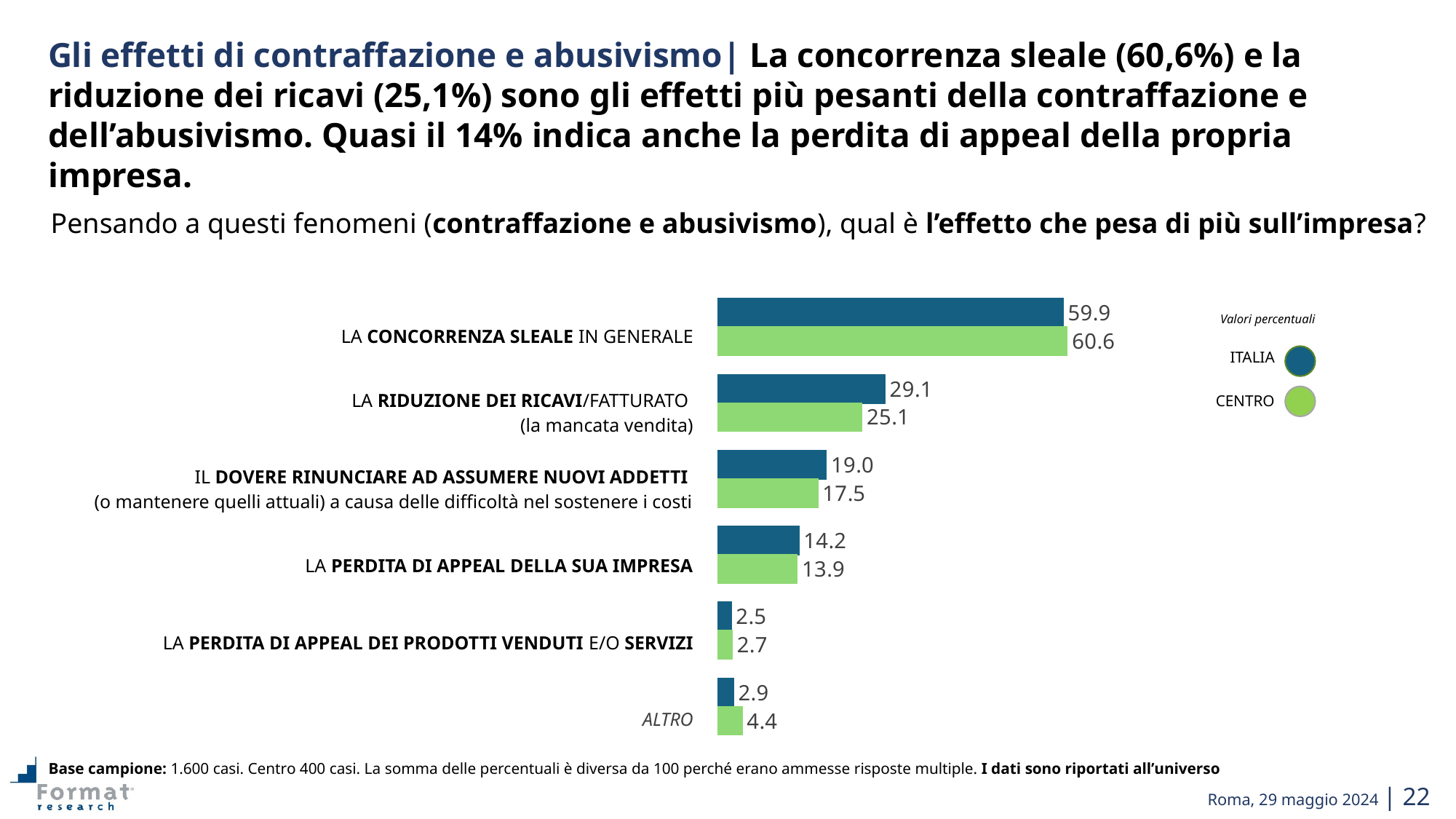
How many categories are shown in the chart? 6 Which category has the highest CENTRO value? LA CONCORRENZA SLEALE IN GENERALE What is the CENTRO value for LA RIDUZIONE DEI RICAVI/FATTURATO? 25.1 For IL DOVERE RINUNCIARE AD ASSUMERE NUOVI ADDETTI, which series has the larger value, ITALIA or CENTRO? ITALIA What is the difference between the ITALIA and CENTRO values for LA RIDUZIONE DEI RICAVI/FATTURATO? 4.0 How many series does the legend list? 2 What is the CENTRO value for ALTRO? 4.4 Which category has the lowest ITALIA value? LA PERDITA DI APPEAL DEI PRODOTTI VENDUTI E/O SERVIZI What kind of chart is shown on the slide? Bar chart What is the ITALIA value for LA PERDITA DI APPEAL DELLA SUA IMPRESA? 14.2 Which colour represents the CENTRO series in the chart? Green What is the ITALIA value for LA CONCORRENZA SLEALE IN GENERALE? 59.9